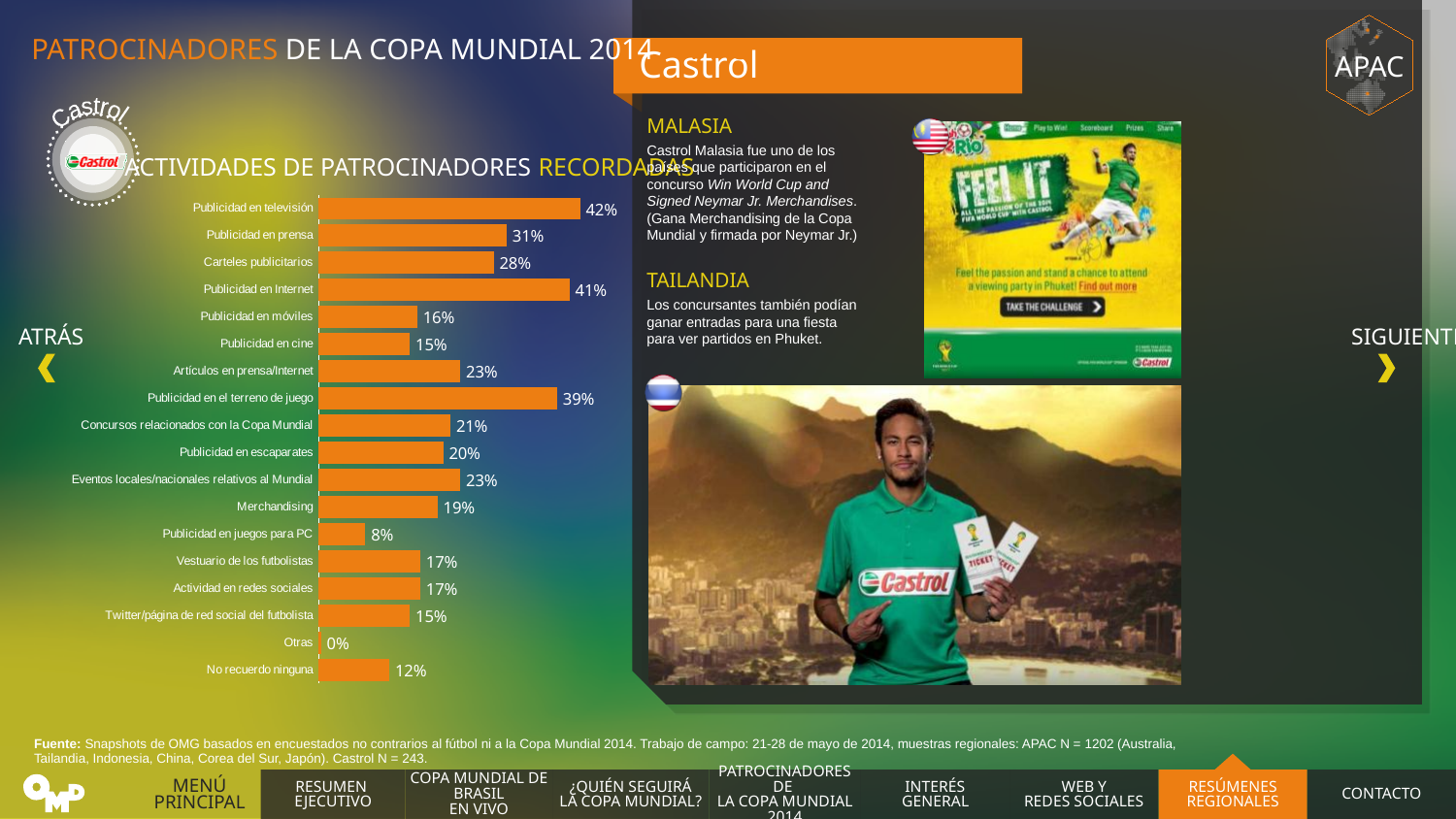
What is the title of the chart? ACTIVIDADES DE PATROCINADORES RECORDADAS What value is shown for No recuerdo ninguna? 12% How many categories are plotted in the chart? 18 Which category has the highest value in the chart? Publicidad en televisión Which category has the lowest value in the chart? Otras What is the difference between Publicidad en televisión and Publicidad en Internet? 1% What type of chart is shown on the slide? Bar chart What is the difference between Publicidad en prensa and Carteles publicitarios? 3% What value is shown for Publicidad en el terreno de juego? 39% What percentage is shown for Merchandising? 19% What percentage is shown for Publicidad en televisión? 42% Which is larger, Publicidad en móviles or Publicidad en juegos para PC? Publicidad en móviles